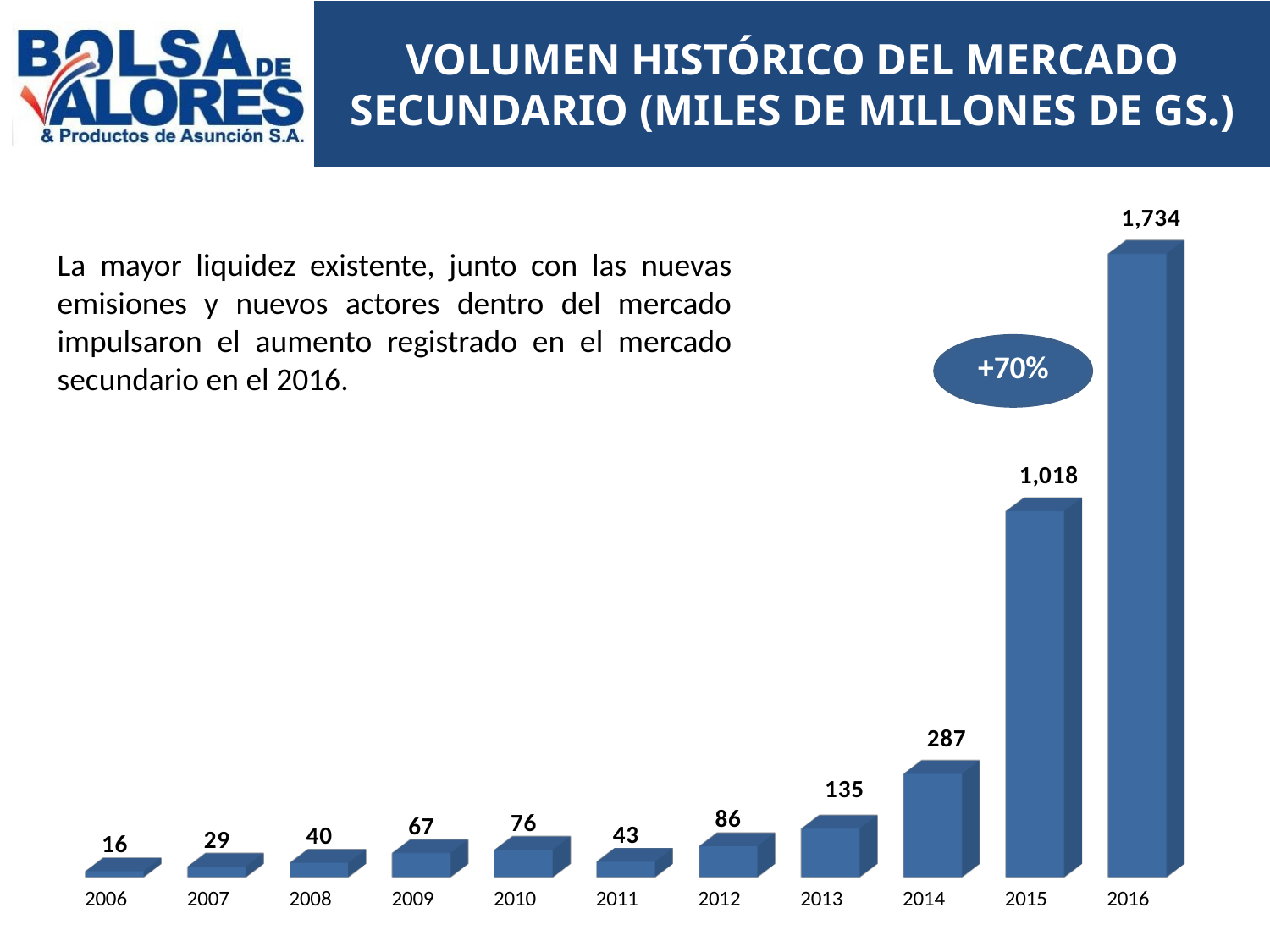
Which is larger, the value for 2009 or the value for 2012? 2012 What is the value for 2011? 43 Do the values generally rise or fall from 2012 to 2016? Rise What is the value for 2016? 1,734 What percentage change is shown in the oval next to the 2016 bar? +70% What is the difference between the values for 2010 and 2011? 33 How many years are shown on the x axis? 11 Which year has the highest value? 2016 What is the difference between the values for 2016 and 2015? 716 Which year has the lowest value? 2006 What is the value for 2014? 287 What kind of chart is shown on the slide? Bar chart